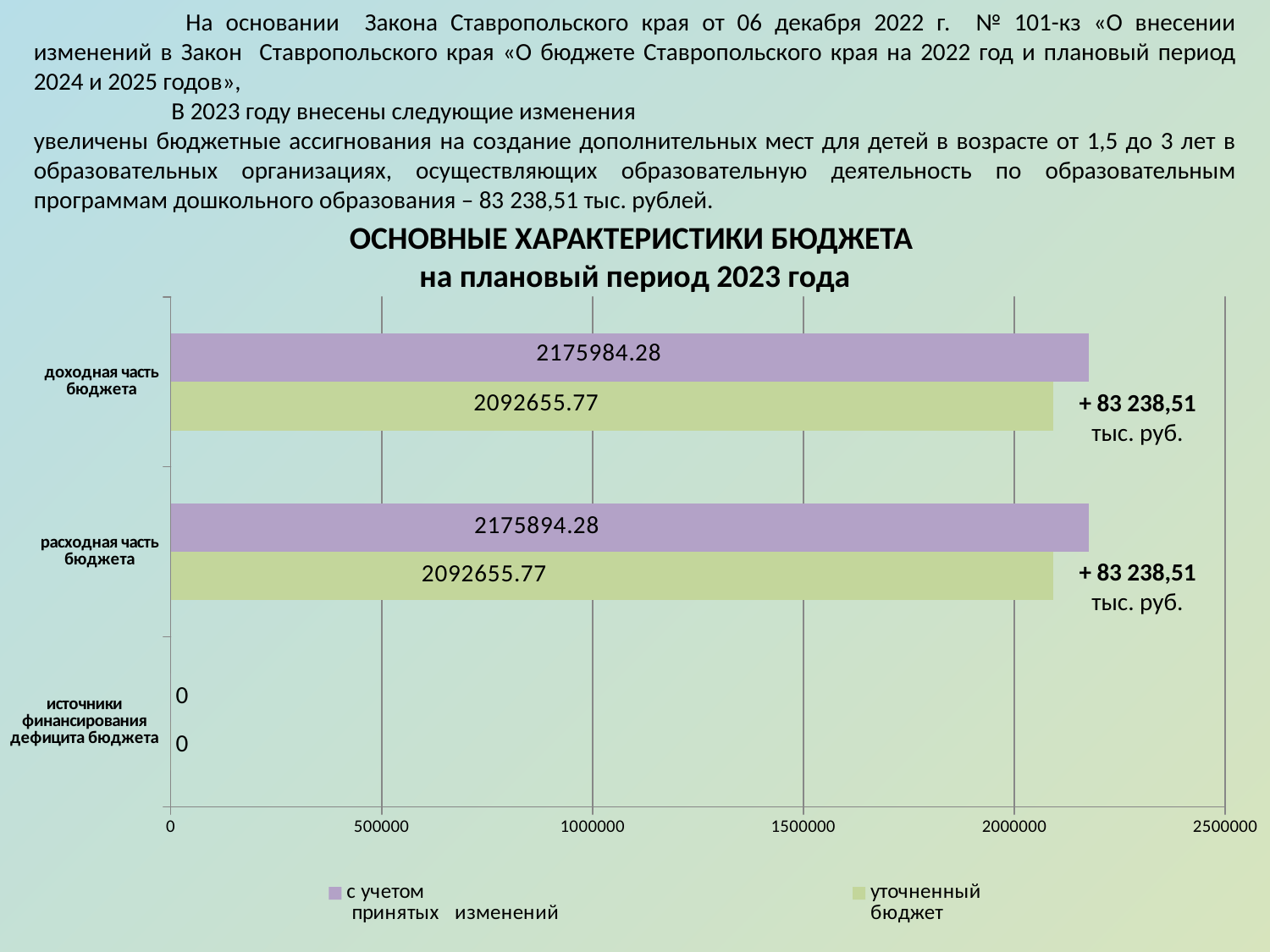
What is the value of 'уточненный бюджет' for 'источники финансирования дефицита бюджета'? 0 How many series does the legend list? 2 Which category has the lowest value for 'уточненный бюджет'? источники финансирования дефицита бюджета What is the value of 'с учетом принятых изменений' for 'расходная часть бюджета'? 2175894.28 What is the value of 'уточненный бюджет' for 'доходная часть бюджета'? 2092655.77 For 'расходная часть бюджета', which is larger: 'с учетом принятых изменений' or 'уточненный бюджет'? с учетом принятых изменений How many categories are shown on the chart? 3 What is the title of the chart? ОСНОВНЫЕ ХАРАКТЕРИСТИКИ БЮДЖЕТА на плановый период 2023 года What is the difference between 'с учетом принятых изменений' and 'уточненный бюджет' for 'расходная часть бюджета'? 83238.51 Is the value of 'уточненный бюджет' for 'доходная часть бюджета' greater or less than 2000000? greater What is the value of 'с учетом принятых изменений' for 'доходная часть бюджета'? 2175984.28 What type of chart is shown on the slide? bar chart